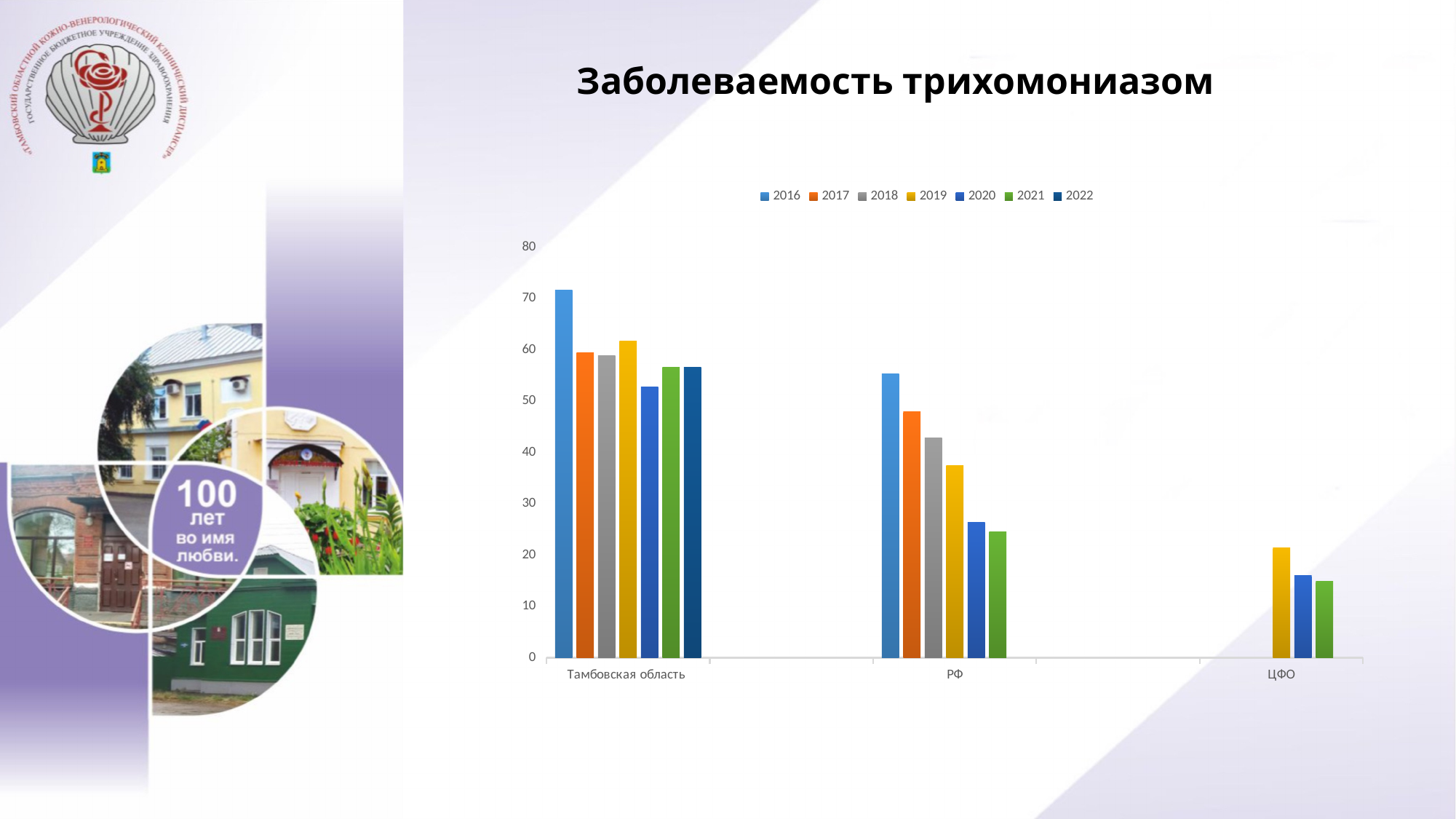
How many categories are shown on the x axis? 3 How many series does the legend list? 7 Is the 2016 value for Тамбовская область greater or less than 70? greater Is the 2020 value for РФ greater or less than 30? less Which is larger for РФ: the 2018 value or the 2019 value? 2018 Which is larger in 2016: the value for Тамбовская область or the value for РФ? Тамбовская область What kind of chart is shown on the slide? bar chart For Тамбовская область, which year has the highest value? 2016 Is the 2021 value for ЦФО greater or less than 20? less What is the title of the chart? Заболеваемость трихомониазом For Тамбовская область, which year has the lowest value? 2020 Do the values for РФ rise or fall from 2016 to 2021? fall